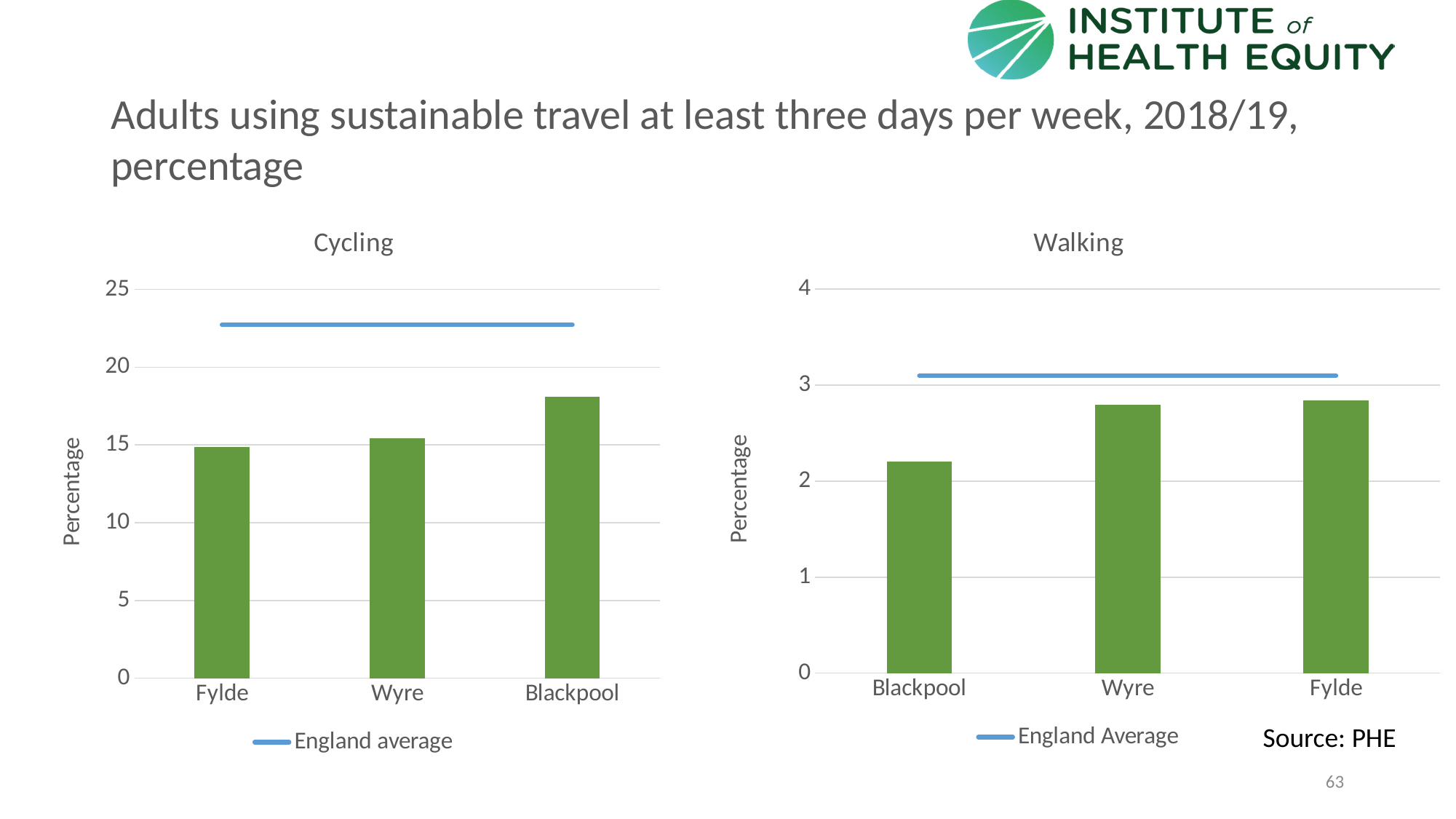
In the Cycling chart, is the value for Blackpool greater or less than 15? greater In the Cycling chart, which area has the lowest bar? Fylde In the Cycling chart, which area has the highest bar? Blackpool In the Walking chart, which is larger, the value for Blackpool or the value for Wyre? Wyre What kind of chart is the Cycling chart? Bar chart In the Walking chart, is the value for Wyre greater or less than 3? less How many areas are shown as bars in the Walking chart? 3 In the Cycling chart, what does the blue horizontal line represent according to the legend? England average In the Cycling chart, is the England average line above or below 20? above In the Walking chart, which area has the lowest bar? Blackpool